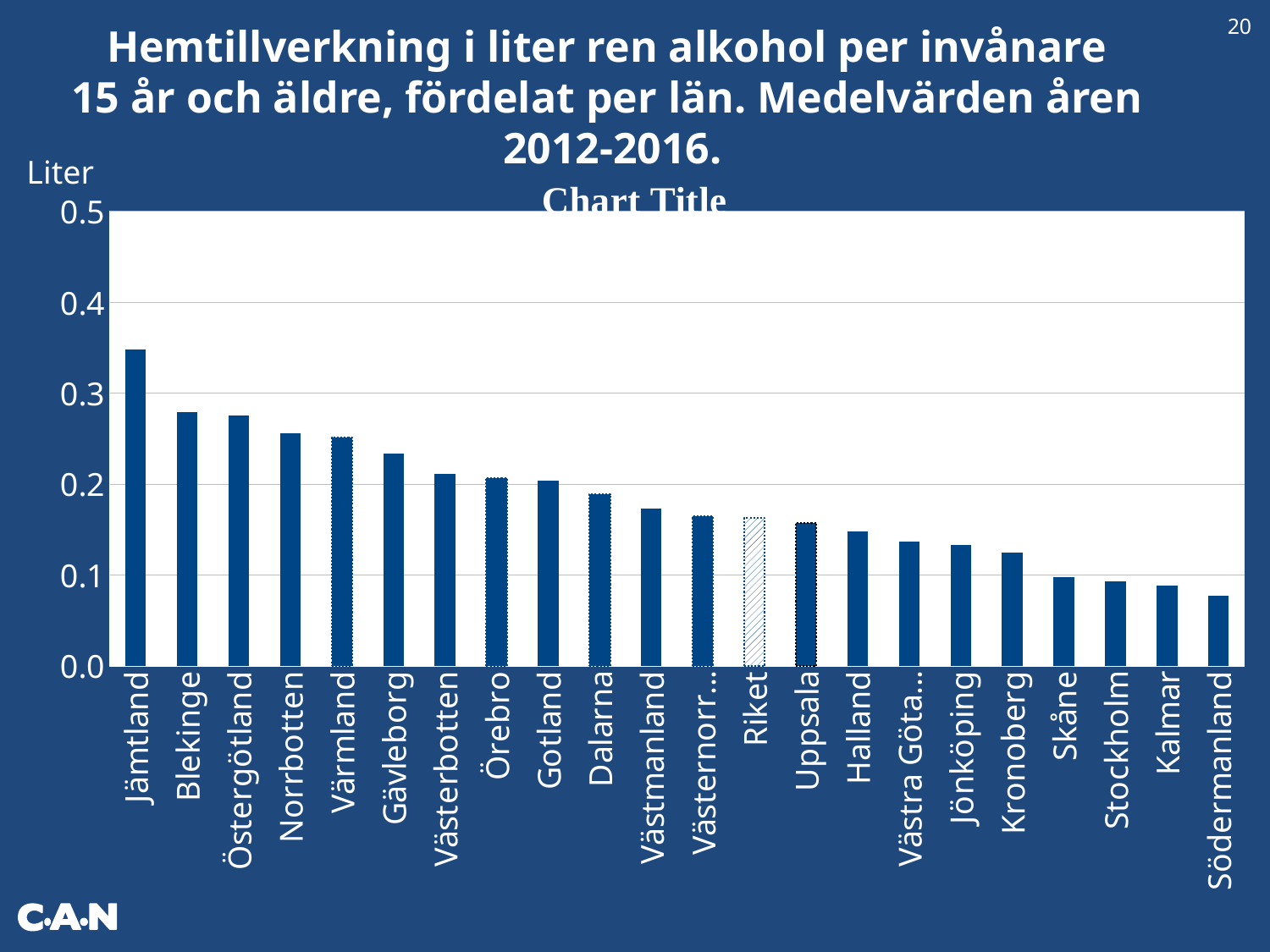
Which county has the highest value in the chart? Jämtland Is the value for Halland greater or less than 0.2? less Is the value for Blekinge greater or less than 0.3? less Which category has the lowest value in the chart? Södermanland Is the value for Södermanland greater or less than 0.1? less Which has the larger value, Gotland or Skåne? Gotland Which has the larger value, Jämtland or Blekinge? Jämtland How many categories are shown on the x axis of the chart? 22 Do the values rise or fall from left to right along the x axis? Fall What kind of chart is shown on the slide? Bar chart